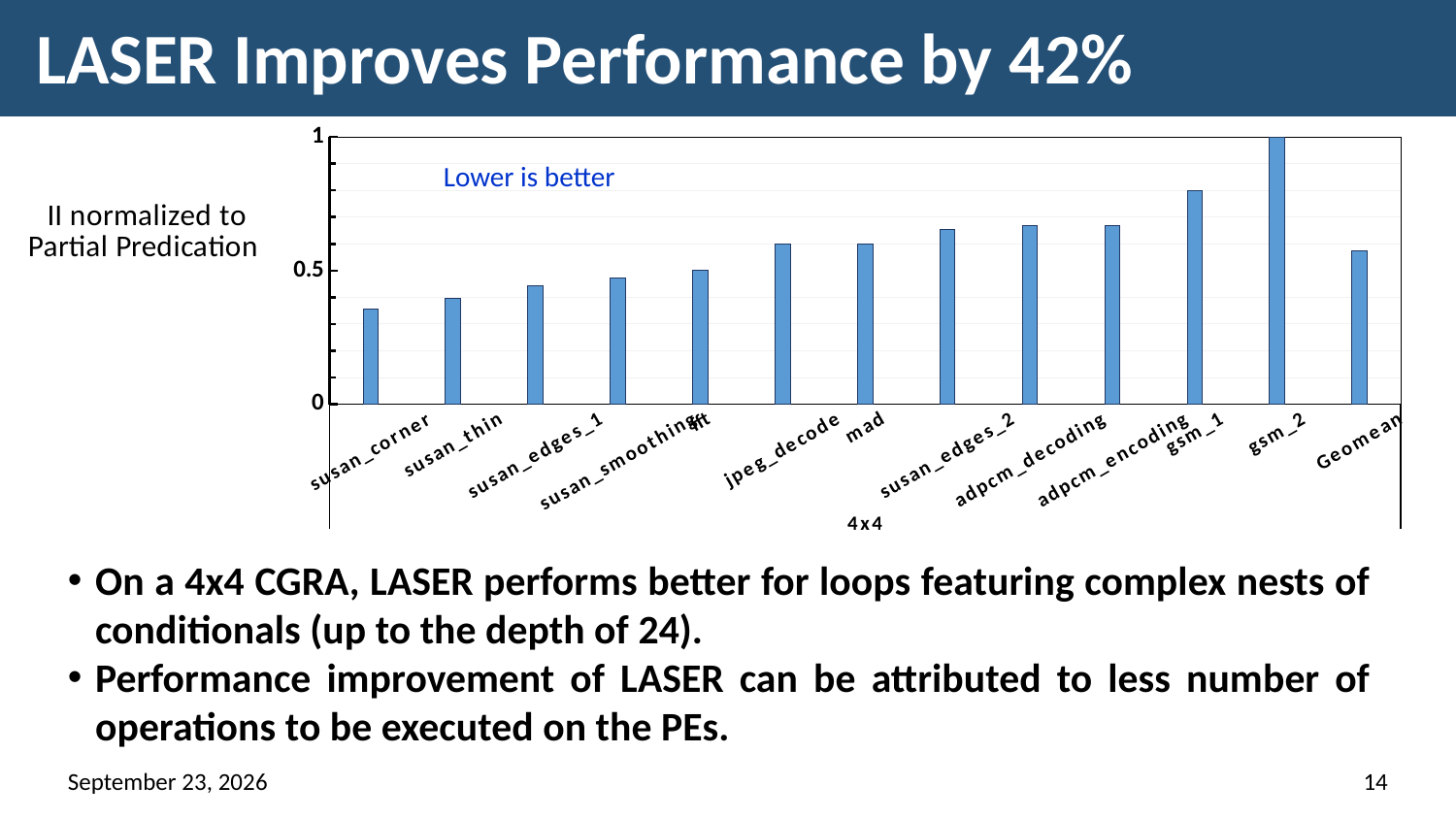
Do the bar values rise or fall from susan_corner to gsm_2 along the x axis? rise Which category has the lowest bar in the chart? susan_corner How many benchmark categories are plotted on the x axis of the chart? 13 Is the value for susan_corner greater or less than 0.5? less What kind of chart is shown on the slide? bar chart Is the value for susan_edges_1 greater or less than 0.5? less Is the value for adpcm_encoding greater or less than 0.5? greater Which has the larger value, susan_thin or gsm_1? gsm_1 What is the value for gsm_2 in the chart? 1 Which category has the highest bar in the chart? gsm_2 What annotation is written inside the plot area of the chart? Lower is better